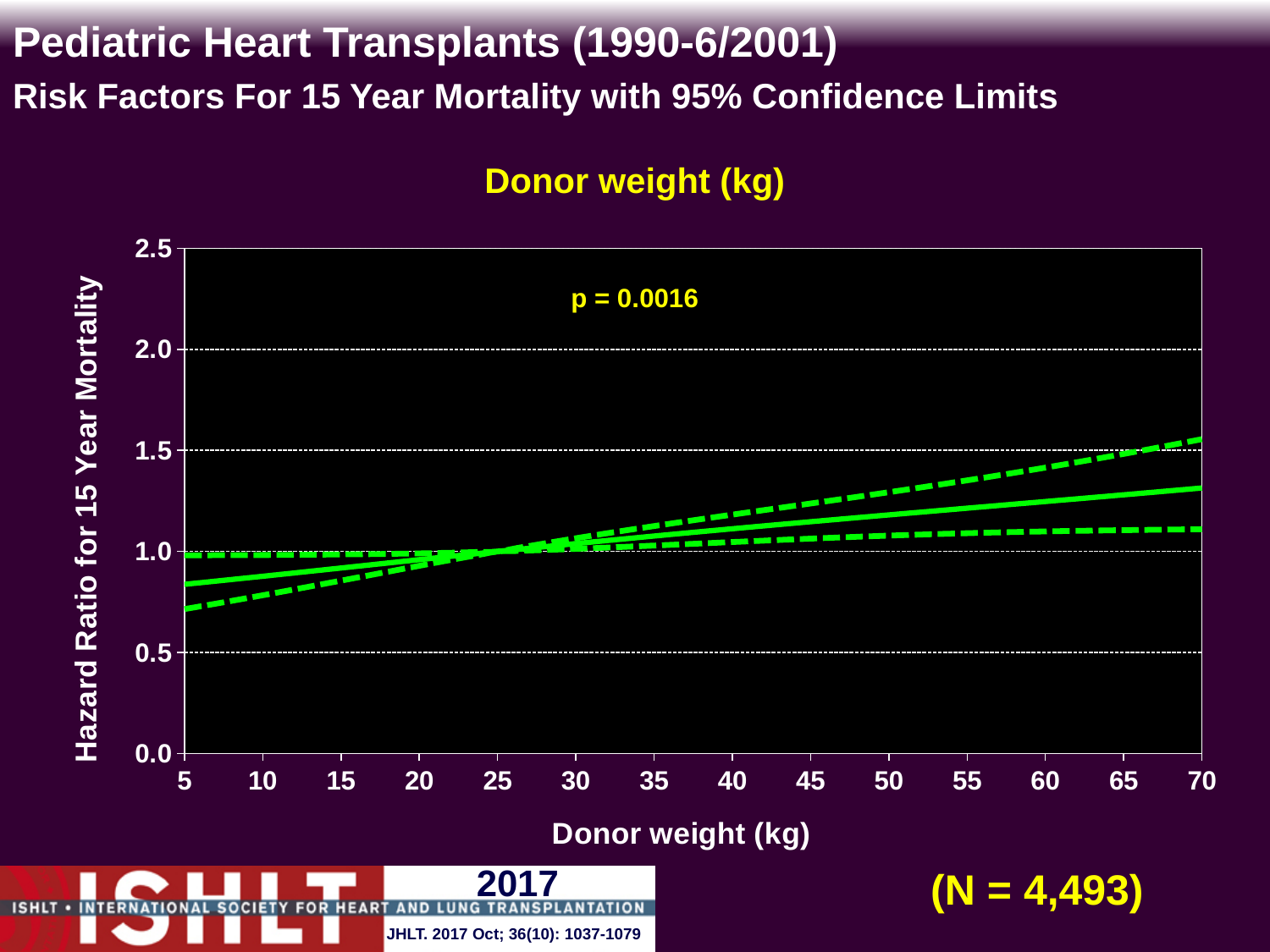
What kind of chart is shown on the slide? line chart Is the hazard ratio on the solid line at a donor weight of 70 kg greater or less than 1.5? less What is the sample size (N) shown on the slide? N = 4,493 How many lines are plotted on the chart? 3 Does the hazard ratio for 15 year mortality rise or fall as donor weight increases from 5 kg to 70 kg? rise Is the hazard ratio on the solid line at a donor weight of 70 kg greater or less than 1.0? greater Is the lower dashed confidence limit at a donor weight of 5 kg greater or less than 1.0? less What p-value is shown on the chart? p = 0.0016 Is the hazard ratio on the solid line higher at a donor weight of 70 kg or at 5 kg? 70 kg